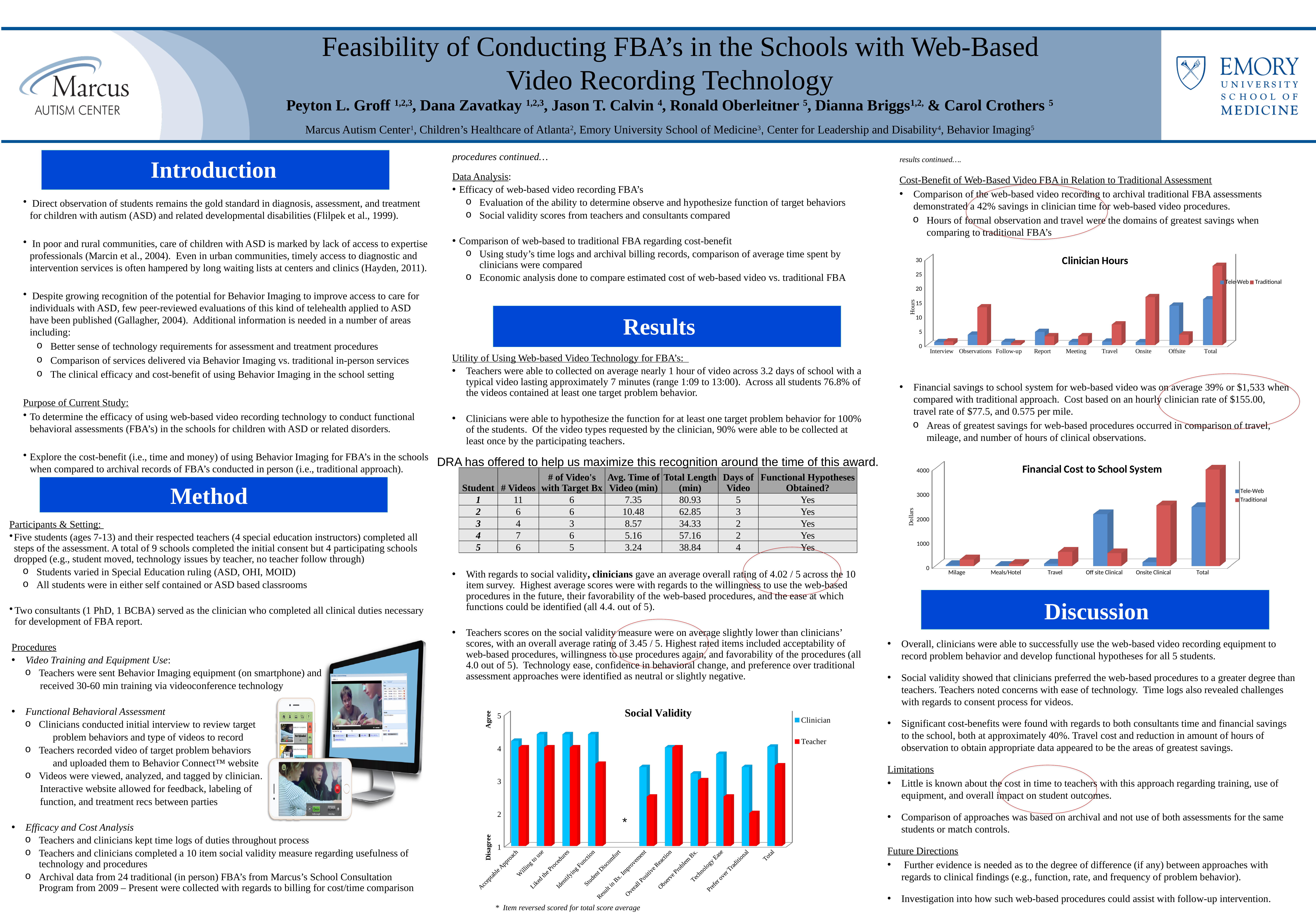
On the Clinician Hours chart, how many categories are shown on the x axis? 9 On the Financial Cost to School System chart, how many categories are shown on the x axis? 6 On the Clinician Hours chart, is the Traditional value for Total greater or less than 25? greater What kind of chart is the Social Validity chart? bar chart On the Social Validity chart, is the Teacher value for Prefer over Traditional greater or less than 3? less On the Clinician Hours chart, is the Tele-Web value for Offsite greater or less than 10? greater On the Social Validity chart, what are the two series listed in the legend? Clinician and Teacher On the Clinician Hours chart, how many series does the legend list? 2 On the Clinician Hours chart, for Onsite, which series has the larger value, Tele-Web or Traditional? Traditional On the Financial Cost to School System chart, for Off site Clinical, which series has the larger value, Tele-Web or Traditional? Tele-Web On the Clinician Hours chart, which category has the tallest Traditional bar? Total